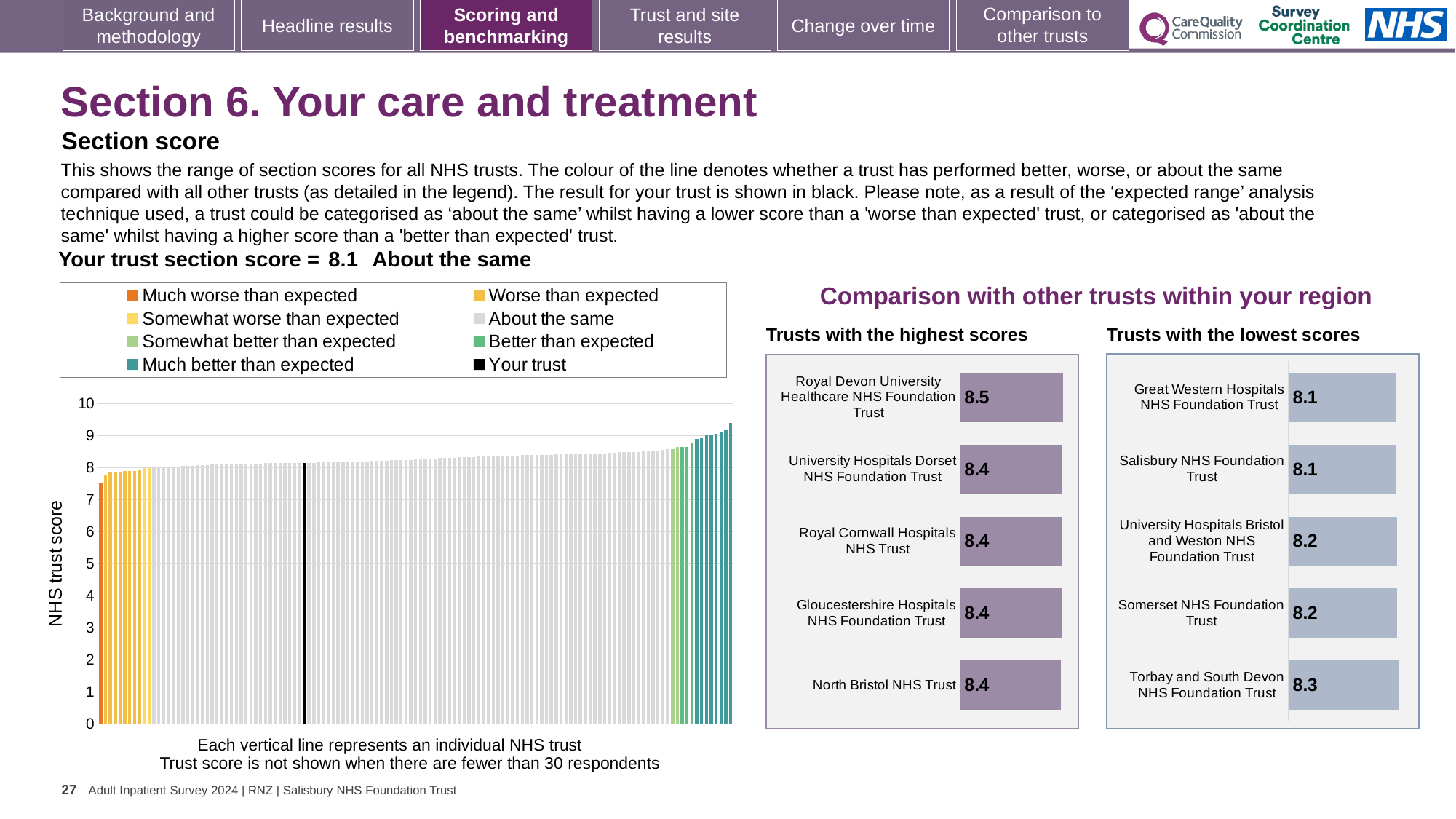
How many trusts are listed in the 'Trusts with the highest scores' chart? 5 In the 'Trusts with the lowest scores' chart, what is the score for Torbay and South Devon NHS Foundation Trust? 8.3 How many entries does the legend of the NHS trust score chart on the left list? 8 In the 'Trusts with the highest scores' chart, which trust has the highest score? Royal Devon University Healthcare NHS Foundation Trust In the 'Trusts with the lowest scores' chart, which has the larger score: Torbay and South Devon NHS Foundation Trust or Somerset NHS Foundation Trust? Torbay and South Devon NHS Foundation Trust In the 'Trusts with the highest scores' chart, what is the difference between the scores of Royal Devon University Healthcare NHS Foundation Trust and North Bristol NHS Trust? 0.1 In the 'Trusts with the lowest scores' chart, what is the difference between the scores of Torbay and South Devon NHS Foundation Trust and Great Western Hospitals NHS Foundation Trust? 0.2 In the NHS trust score chart on the left, do the trust scores rise or fall from left to right along the x axis? Rise In the NHS trust score chart on the left, is the value of the black 'Your trust' bar greater or less than 9? less In the 'Trusts with the lowest scores' chart, which trust has the highest score shown? Torbay and South Devon NHS Foundation Trust What kind of chart is the 'Trusts with the lowest scores' chart? Bar chart In the 'Trusts with the highest scores' chart, what is the score for Royal Devon University Healthcare NHS Foundation Trust? 8.5